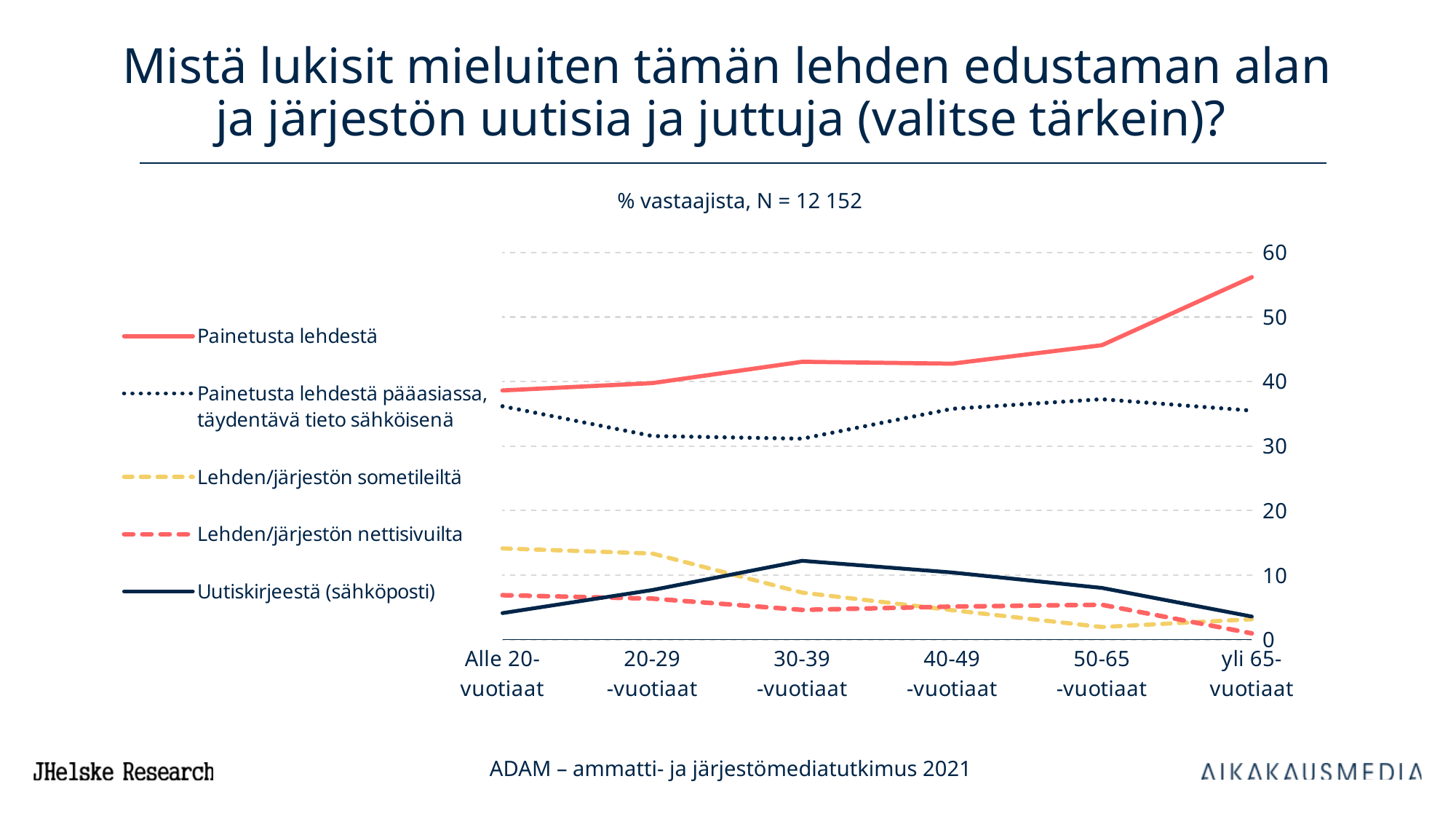
Is the value for Uutiskirjeestä (sähköposti) among 30-39-vuotiaat greater or less than 10? greater In which age group is the value for Painetusta lehdestä highest? yli 65-vuotiaat Does the value for Painetusta lehdestä rise or fall from Alle 20-vuotiaat to yli 65-vuotiaat? rise What kind of chart is shown on the slide? line chart In which age group is the value for Uutiskirjeestä (sähköposti) highest? 30-39-vuotiaat What is the subtitle shown above the chart? % vastaajista, N = 12 152 Among 30-39-vuotiaat, which is larger: Painetusta lehdestä or Painetusta lehdestä pääasiassa, täydentävä tieto sähköisenä? Painetusta lehdestä Is the value for Lehden/järjestön nettisivuilta among yli 65-vuotiaat greater or less than 10? less Is the value for Painetusta lehdestä among yli 65-vuotiaat greater or less than 50? greater How many age groups are shown on the x axis? 6 How many series does the legend list? 5